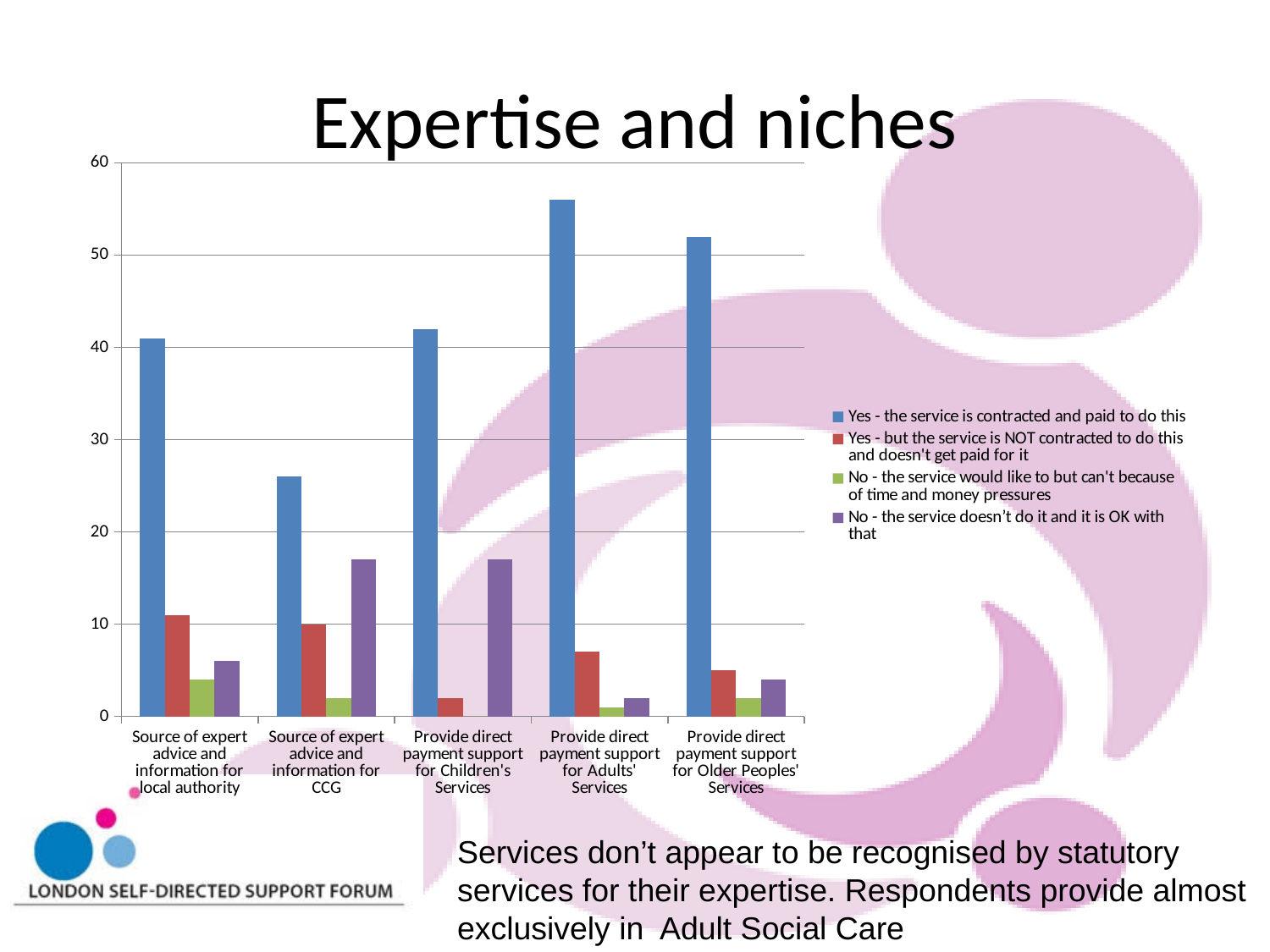
What is the title of the slide containing the chart? Expertise and niches How many series does the chart's legend list? 4 How many categories are shown along the x axis of the chart? 5 For 'Provide direct payment support for Children's Services', which is larger: the value for 'Yes - the service is contracted and paid to do this' or the value for 'No - the service doesn't do it and it is OK with that'? Yes - the service is contracted and paid to do this Is the value for 'Yes - the service is contracted and paid to do this' in 'Provide direct payment support for Adults' Services' greater or less than 50? greater Is the value for 'No - the service doesn't do it and it is OK with that' in 'Source of expert advice and information for CCG' greater or less than 10? greater Which category has the highest value for the series 'Yes - the service is contracted and paid to do this'? Provide direct payment support for Adults' Services What kind of chart is shown on the slide? bar chart Which category has the lowest value for the series 'Yes - the service is contracted and paid to do this'? Source of expert advice and information for CCG Which series is shown in blue in the chart's legend? Yes - the service is contracted and paid to do this Is the value for 'Yes - the service is contracted and paid to do this' in 'Source of expert advice and information for CCG' greater or less than 30? less